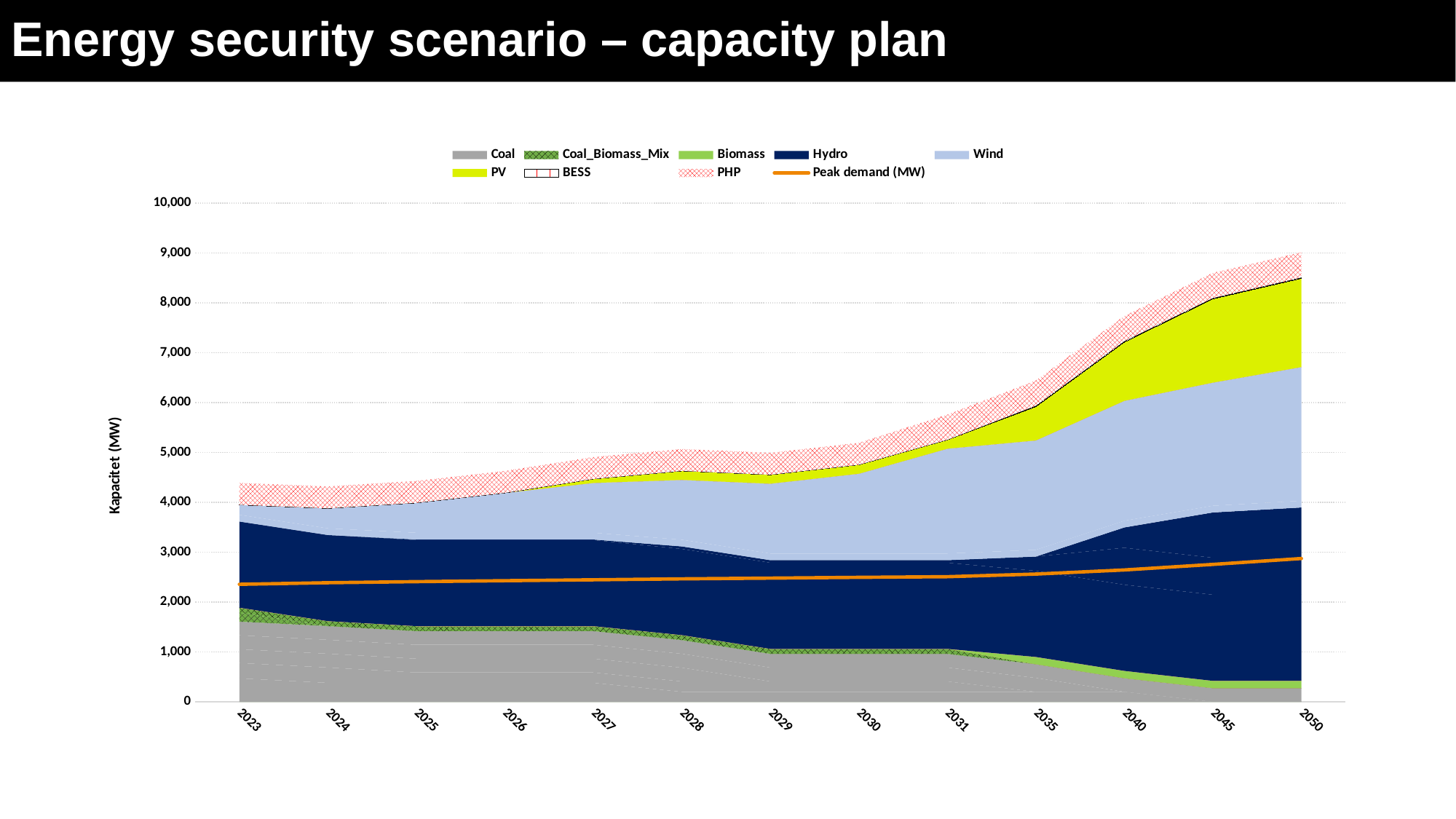
How many series does the legend list? 9 Does the Peak demand (MW) line rise or fall from 2023 to 2050? Rises Does the Coal area get larger or smaller from 2023 to 2050? Smaller How many years are shown on the x axis? 13 What kind of chart is shown on the slide? Stacked area chart with a line What is the label of the y axis? Kapacitet (MW) Is the Peak demand (MW) value in 2023 greater or less than 3,000? less Is the total stacked capacity in 2050 greater or less than 8,000? greater Does the total stacked capacity rise or fall from 2023 to 2050? Rises Which colour represents PV in the legend? Yellow Is the total stacked capacity in 2023 greater or less than 4,000? greater